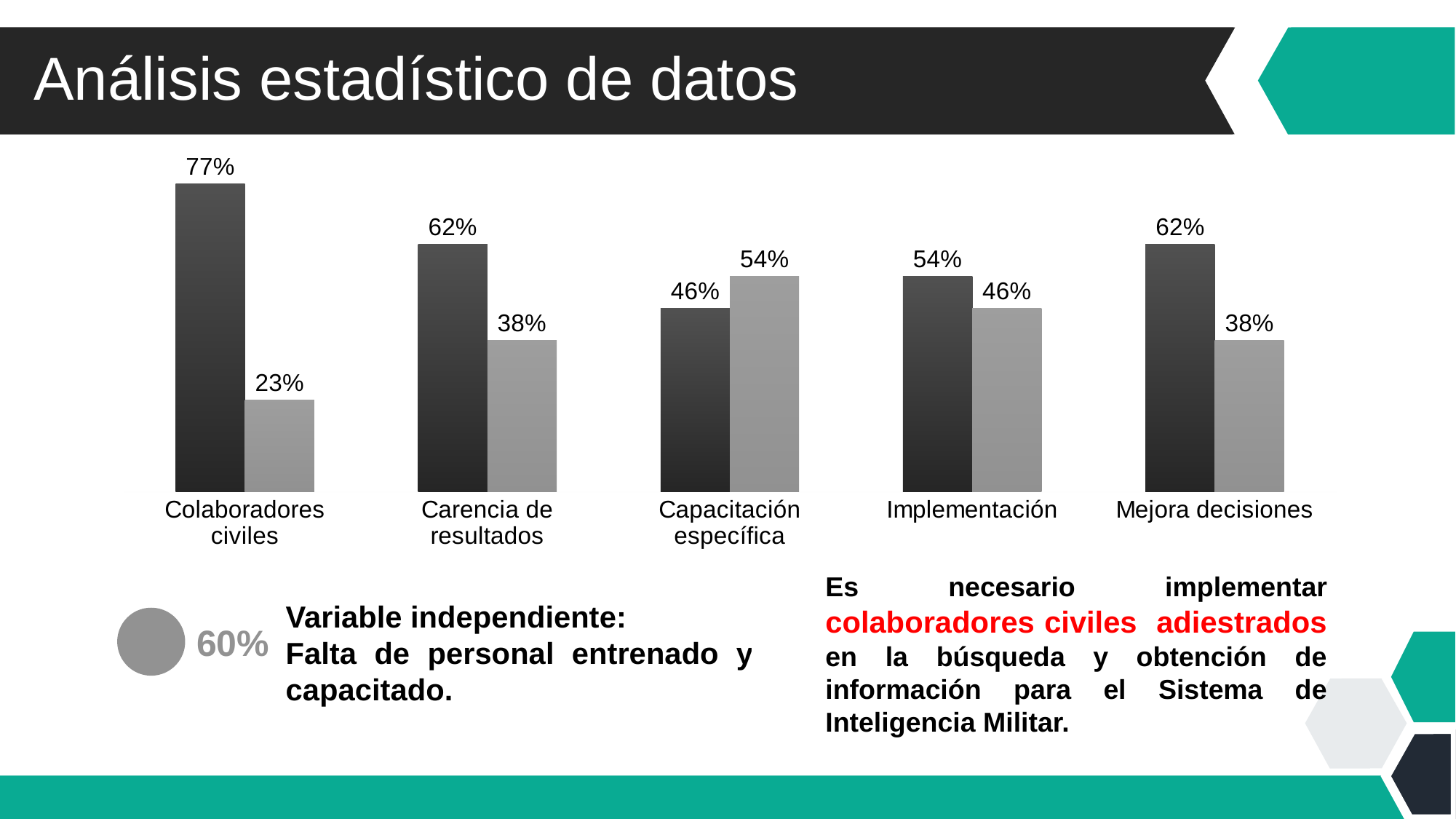
What value does the light grey bar show for Carencia de resultados? 38% What value does the dark bar show for Capacitación específica? 46% For Capacitación específica, which bar is larger, the dark bar or the light grey bar? the light grey bar Which category has the lowest light grey bar value? Colaboradores civiles How many categories are shown on the x axis of the chart? 5 What value does the light grey bar show for Colaboradores civiles? 23% What value does the dark bar show for Colaboradores civiles? 77% What is the difference between the dark bar and the light grey bar for Colaboradores civiles? 54% What value does the light grey bar show for Implementación? 46% What is the difference between the dark bar values for Carencia de resultados and Implementación? 8% Which category has the highest dark bar value? Colaboradores civiles What kind of chart is shown on the slide? bar chart